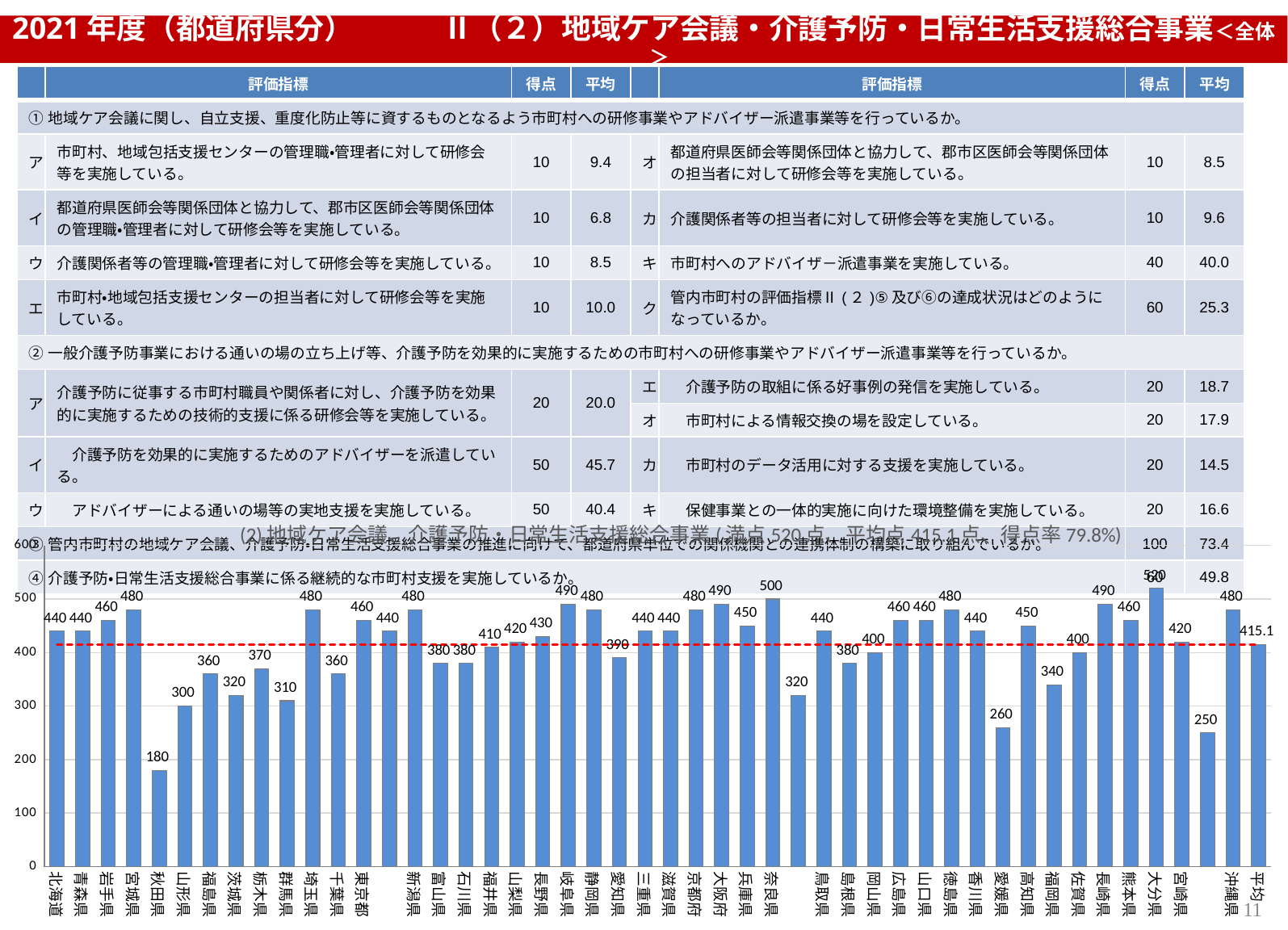
According to the chart title, what is the 得点率 (score rate)? 79.8% Which prefecture has the highest value in the bar chart? 大分県 Is the value for 福岡県 in the bar chart greater or less than 400? less What is the difference between the values for 大分県 and 秋田県 in the bar chart? 340 What is the value for 奈良県 in the bar chart? 500 What is the value for 愛媛県 in the bar chart? 260 What is the value for 秋田県 in the bar chart? 180 What is the value shown for 平均 at the right end of the bar chart? 415.1 What kind of chart is shown at the bottom of the slide? bar chart Which prefecture has the lowest value in the bar chart? 秋田県 Which has a larger value in the bar chart, 岐阜県 or 愛知県? 岐阜県 According to the chart title, what is the 満点 (maximum score)? 520 点